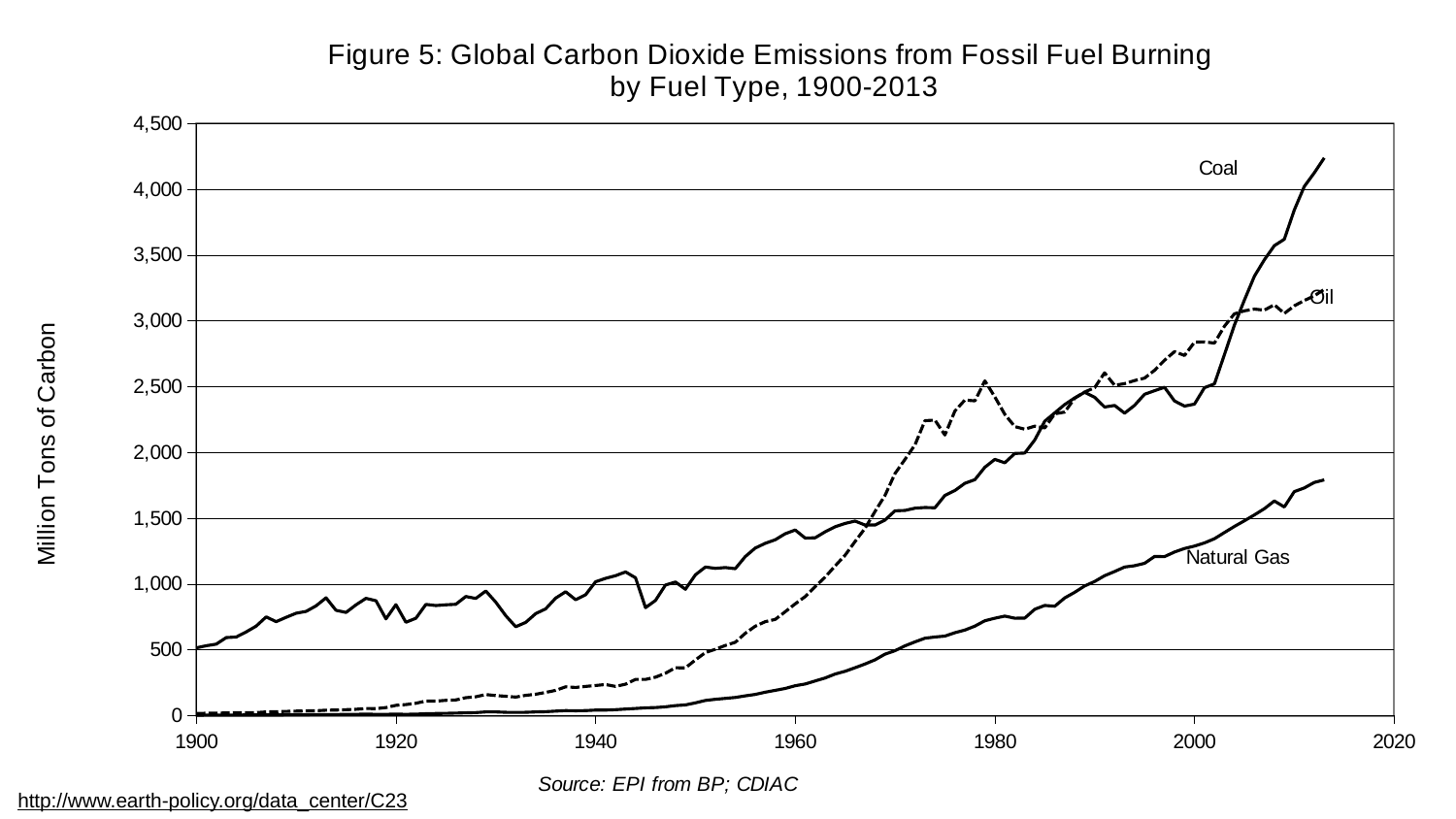
What kind of chart is shown on the slide? line chart Is the value for Coal in 2013 greater or less than 4,000? greater Is the value for Natural Gas in 2000 greater or less than 1,000? greater Is the value for Natural Gas in 2013 greater or less than 2,000? less In 1980, which is larger: emissions from Oil or from Coal? Oil Which fuel type has the highest emissions at the end of the series in 2013? Coal How many fuel-type series are plotted on the chart? 3 What is the label on the y axis of the chart? Million Tons of Carbon Does the Natural Gas line generally rise or fall from 1900 to 2013? rise Which fuel type has the lowest emissions in 2013? Natural Gas Which fuel type is drawn with a dashed line? Oil